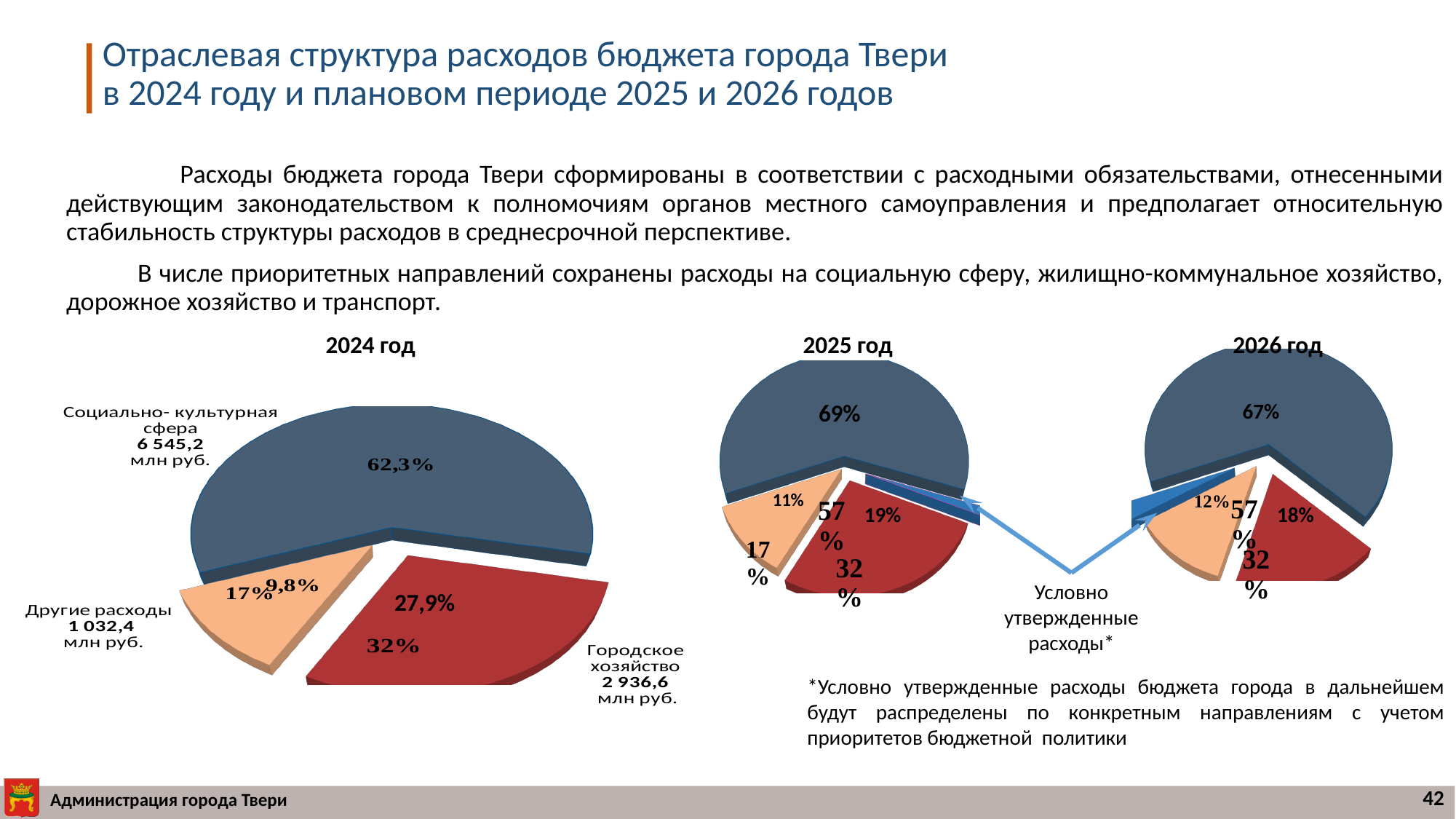
In the 2026 год chart, what percentage is labelled on the largest (dark blue) slice? 67% In the 2024 год chart, what is the difference in млн руб. between Социально-культурная сфера and Городское хозяйство? 3 608,6 млн руб. In the 2024 год chart, what amount in млн руб. is shown for Другие расходы? 1 032,4 млн руб. In the 2024 год chart, which category has the smallest slice? Другие расходы In the 2024 год chart, which is larger: Городское хозяйство or Другие расходы? Городское хозяйство In the 2024 год chart, what amount in млн руб. is shown for Городское хозяйство? 2 936,6 млн руб. In the 2024 год chart, what percentage share is labelled on the Социально-культурная сфера slice? 62,3% In the 2024 год chart, what amount in млн руб. is shown for Социально-культурная сфера? 6 545,2 млн руб. In the 2024 год chart, what percentage share is labelled on the Городское хозяйство slice? 27,9% In the 2024 год chart, which category has the largest slice? Социально-культурная сфера What kind of chart is used for the 2024 год chart? pie chart